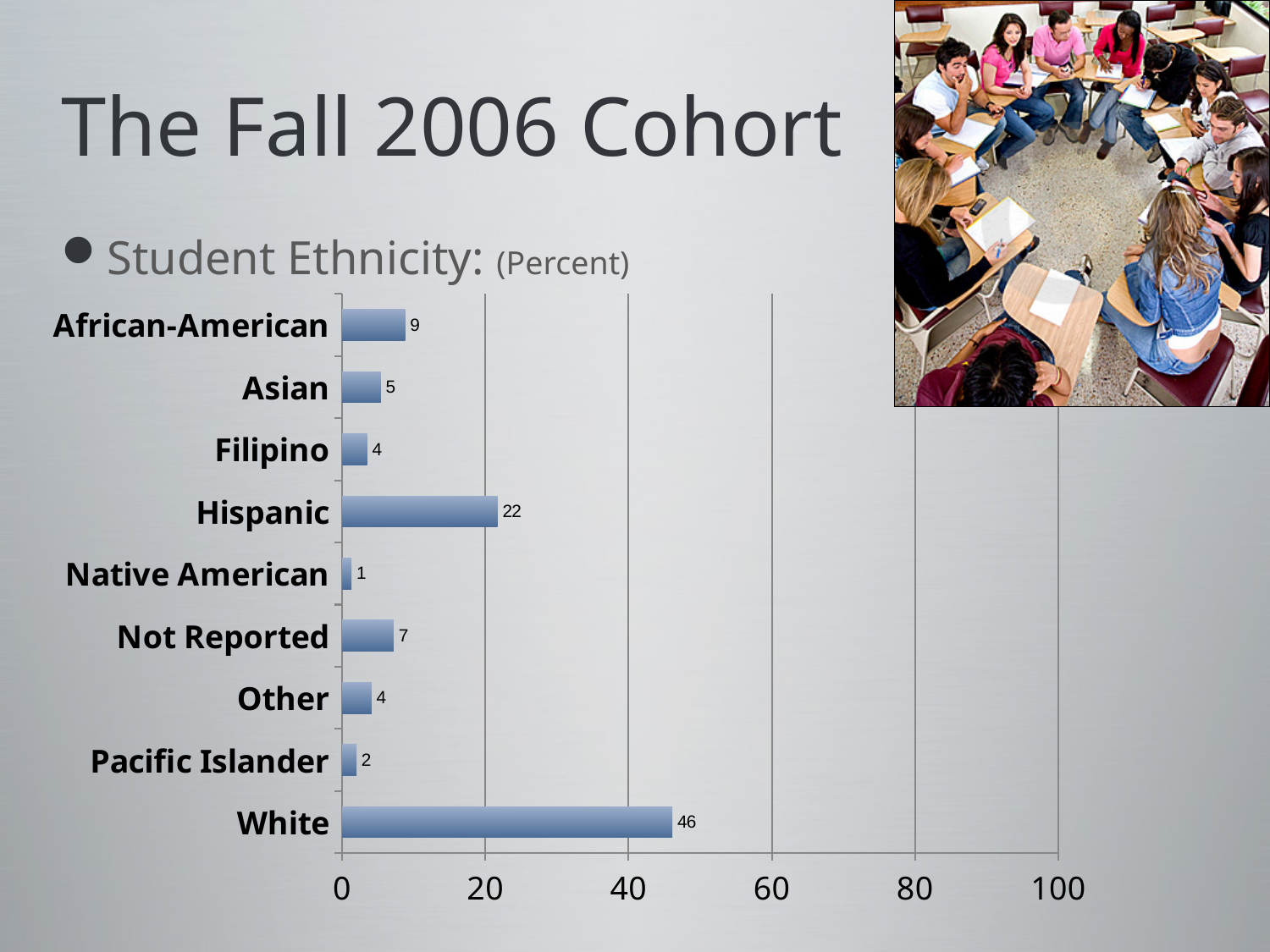
What is the value for Hispanic? 22 What kind of chart is shown on the slide? bar chart What unit are the chart values given in, according to the slide? Percent Which category has the highest value? White Which category has the lowest value? Native American Which is larger, the value for Asian or the value for Not Reported? Not Reported What is the value for Not Reported? 7 Is the value for White greater or less than 40? greater What is the value for African-American? 9 What is the value for White? 46 How many categories are shown in the chart? 9 What is the difference between the values for White and Hispanic? 24